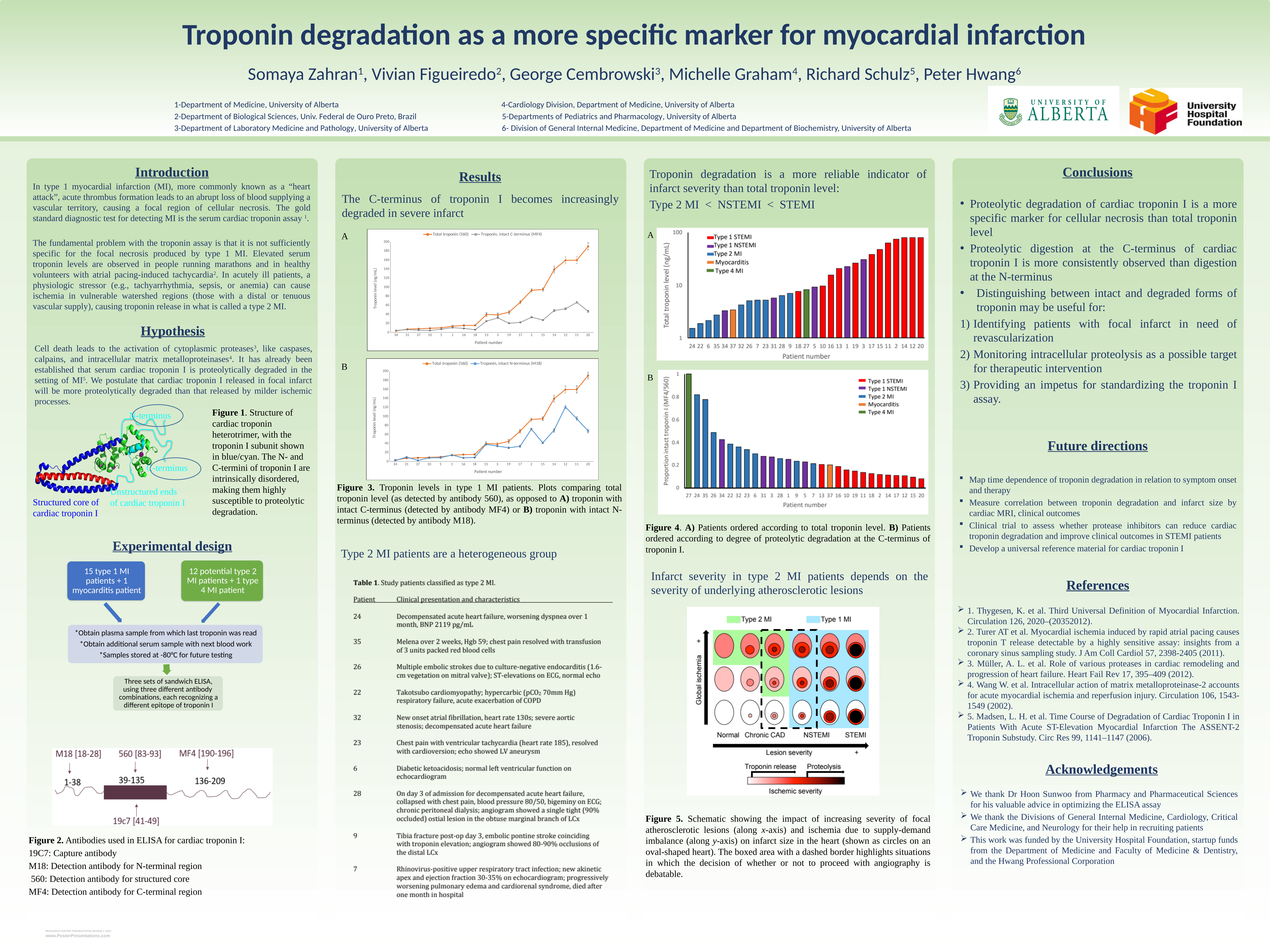
In Figure 3A, is the total troponin (560) value for patient 20 greater or less than 160 ng/mL? greater In Figure 4A (patients ordered by total troponin level), what kind of chart is shown? bar chart In Figure 3A (total troponin vs intact C-terminus), how many series does the legend list? 2 In Figure 4A, how many patients are plotted along the x axis? 29 In Figure 4B, is the proportion of intact troponin I for patient 24 greater or less than 0.6? greater In Figure 4A, which patient number has the highest total troponin level? 20 In Figure 4A, how many series does the legend list? 5 In Figure 4A, which patient number has the lowest total troponin level? 24 In Figure 4B (proportion intact troponin I), which patient number has the highest proportion of intact troponin I? 27 In Figure 4A, do the total troponin values rise or fall from left to right along the x axis? rise In Figure 4B, which has the larger proportion of intact troponin I, patient 27 or patient 20? patient 27 In Figure 4A, is the total troponin level for patient 24 greater or less than 10 ng/mL? less